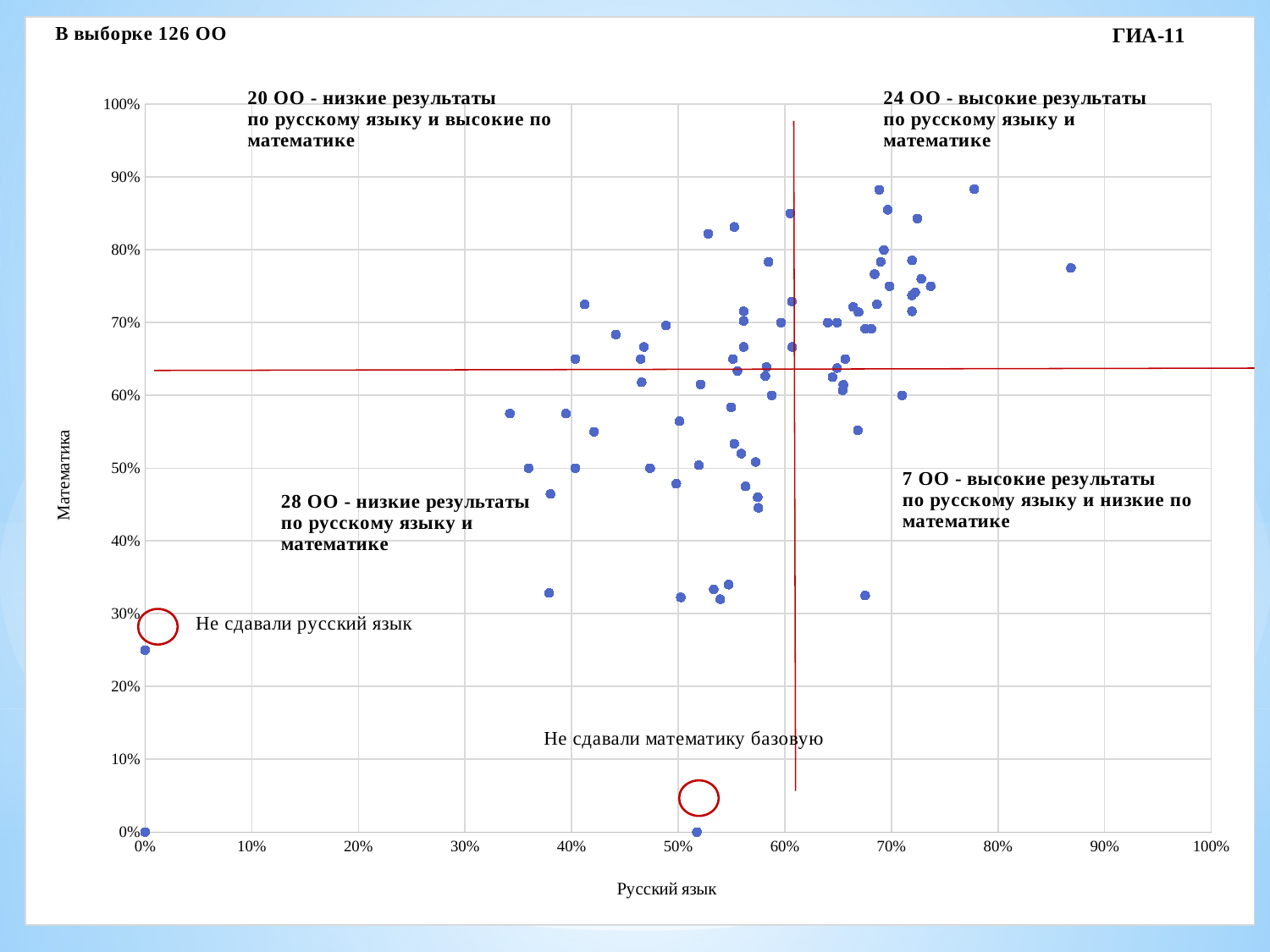
What is the title of the vertical axis of the chart? Математика What kind of chart is shown on the slide? scatter chart According to the annotation on the chart, how many ОО have high results in Russian and low results in mathematics? 7 ОО Is the mathematics value of the rightmost point on the chart (near 87% in Russian) greater or less than 70%? greater How many ОО are in the sample according to the text at the top of the slide? 126 ОО Is the Russian value of the rightmost point on the chart greater or less than 80%? greater Is the mathematics value of the highest point on the chart greater or less than 80%? greater What is the title of the horizontal axis of the chart? Русский язык According to the annotation on the chart, how many ОО have high results in both Russian and mathematics? 24 ОО